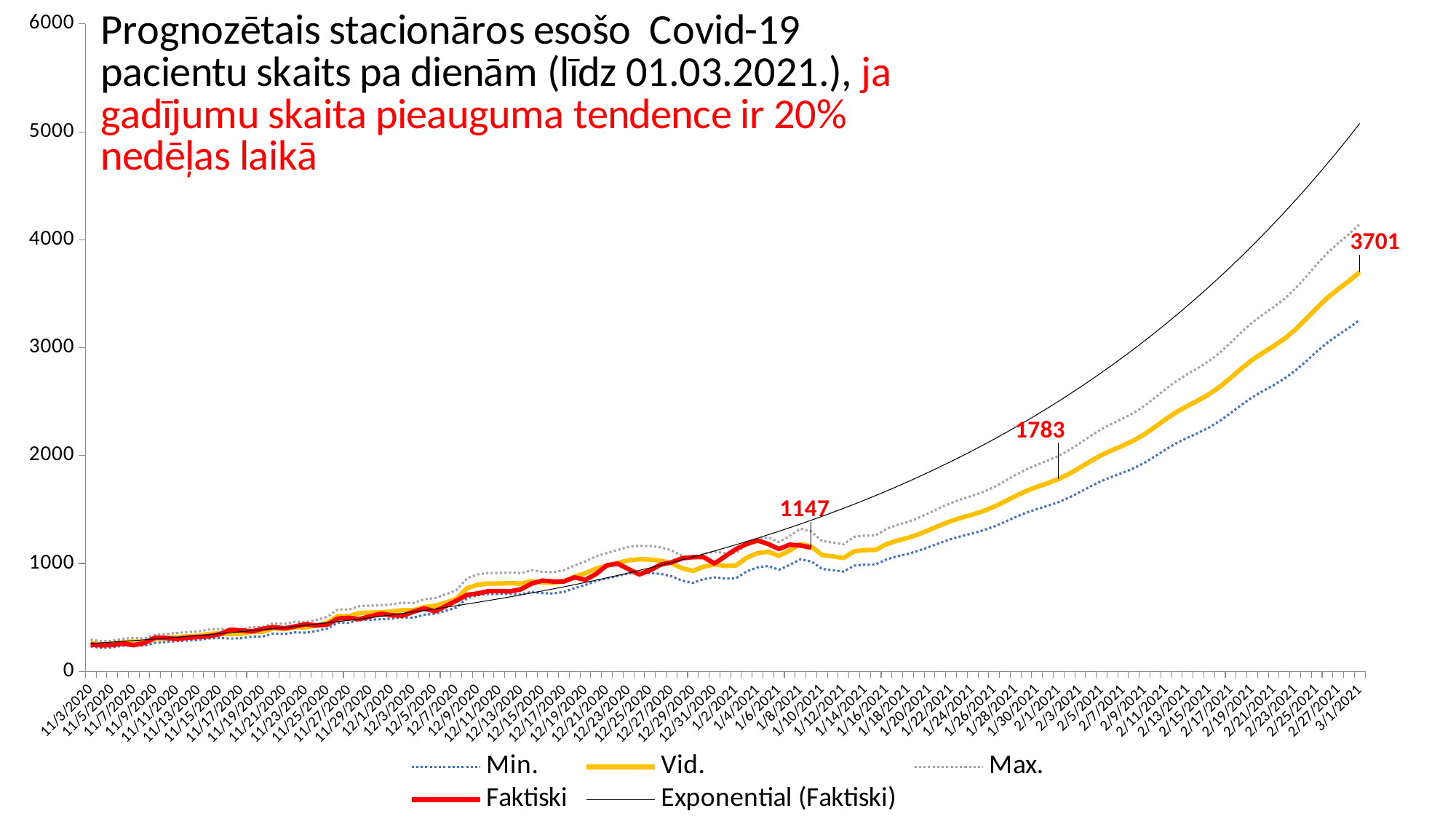
Which series is drawn as a thick red line? Faktiski What is the difference between the labelled values 1783 and 1147? 636 Which series has the highest value at 3/1/2021? Exponential (Faktiski) What is the labelled value on the Vid. line at 2/1/2021? 1783 Does the Vid. line rise or fall from 11/3/2020 to 3/1/2021? rise What is the difference between the labelled values 3701 and 1783? 1918 How many series does the legend list? 5 Is the value of the Max. line at 3/1/2021 greater or less than 4000? greater What kind of chart is shown on the slide? line chart What is the labelled value on the Vid. line at 3/1/2021? 3701 Is the value of the Min. line at 3/1/2021 greater or less than 3500? less